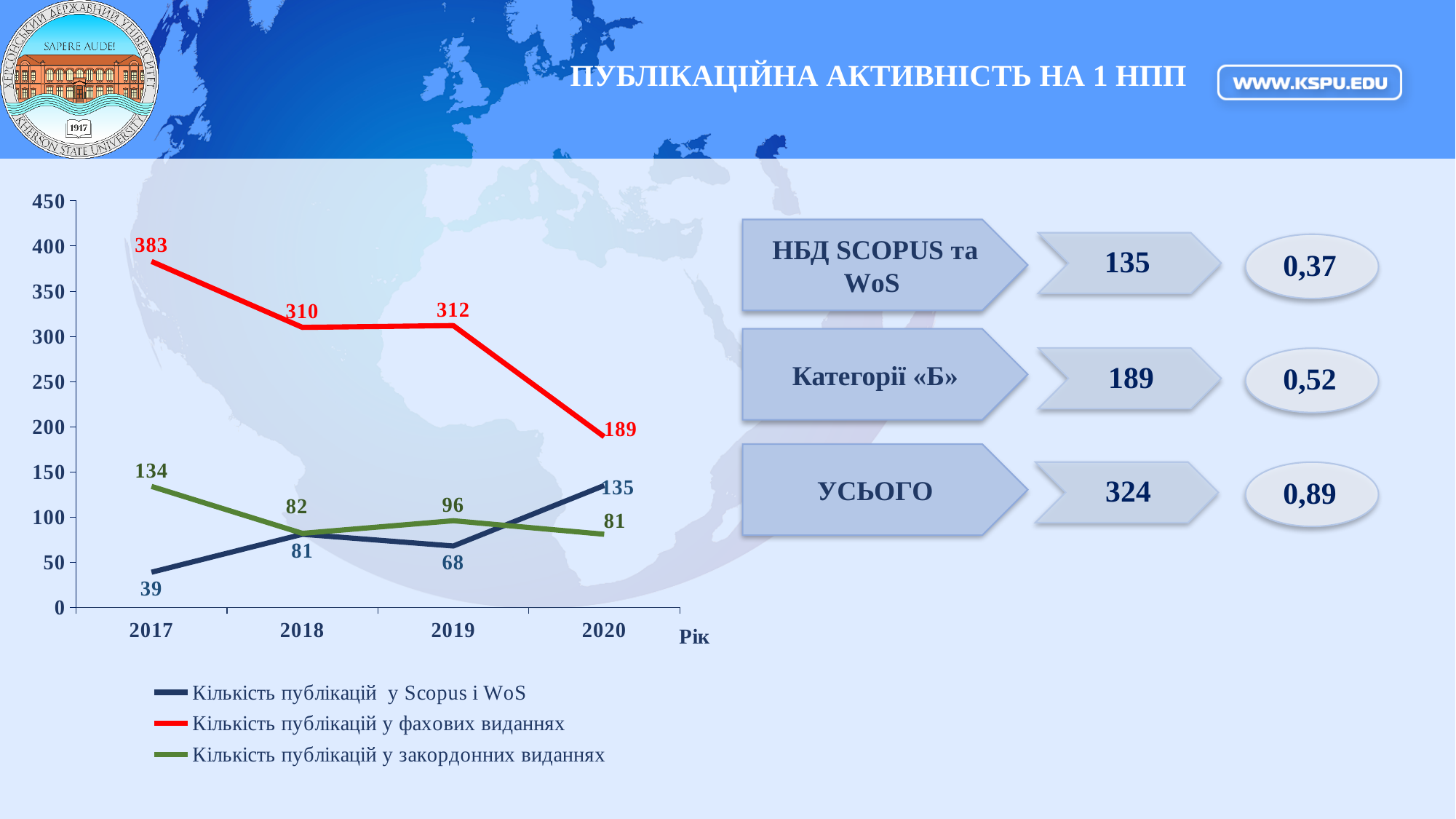
Which is larger in 2020: 'Кількість публікацій у Scopus і WoS' or 'Кількість публікацій у закордонних виданнях'? Кількість публікацій у Scopus і WoS What is the value of 'Кількість публікацій у закордонних виданнях' in 2019? 96 In which year is 'Кількість публікацій у Scopus і WoS' lowest? 2017 What colour is the line for 'Кількість публікацій у фахових виданнях'? red How many series does the chart legend list? 3 Does 'Кількість публікацій у фахових виданнях' generally rise or fall from 2017 to 2020? fall What is the difference between the 2017 and 2020 values of 'Кількість публікацій у фахових виданнях'? 194 In which year is 'Кількість публікацій у фахових виданнях' highest? 2017 How many years are shown on the x axis of the chart? 4 What is the value of 'Кількість публікацій у фахових виданнях' in 2017? 383 What type of chart is shown on the slide? line chart What is the value of 'Кількість публікацій у Scopus і WoS' in 2020? 135